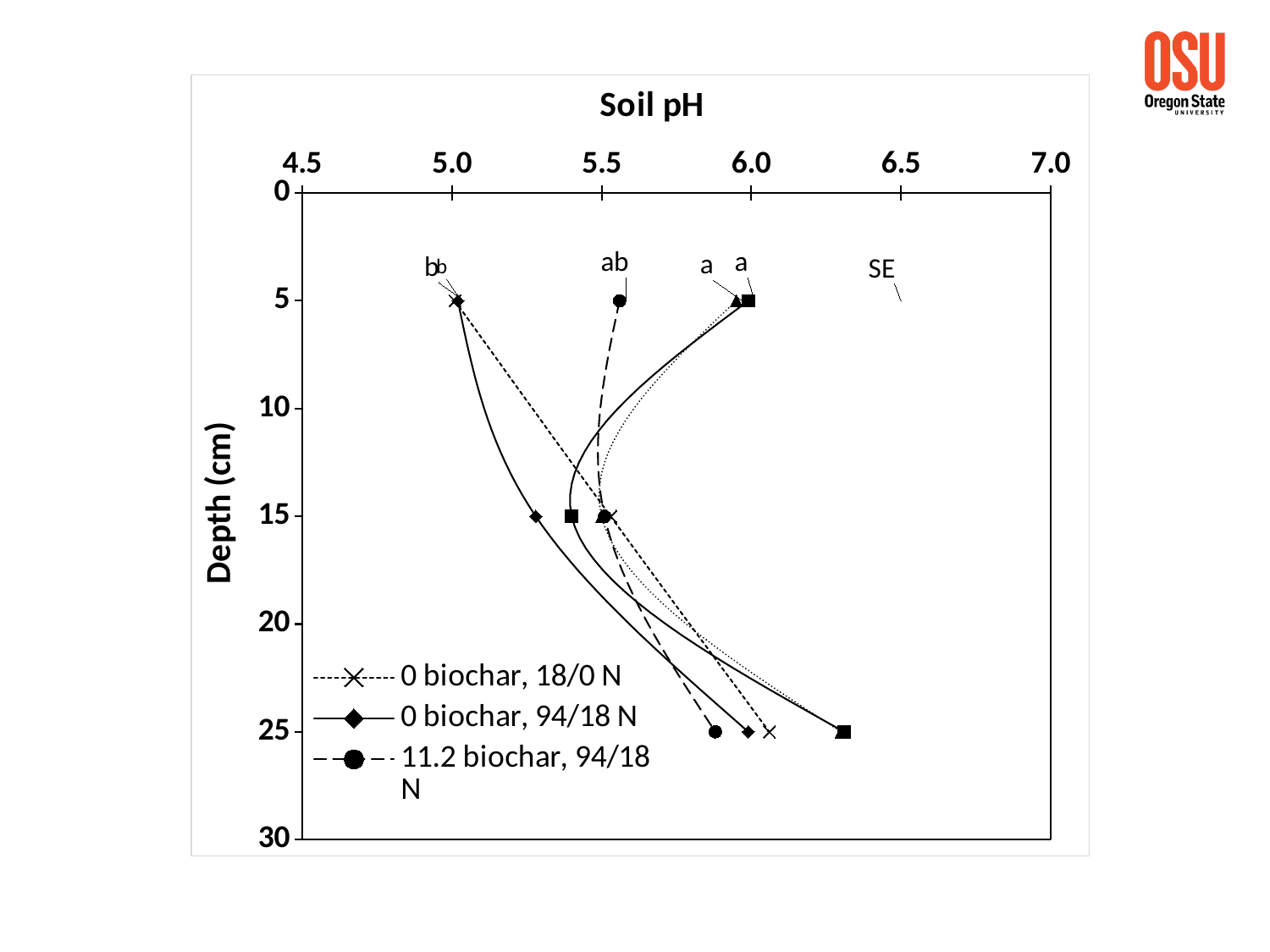
Is the soil pH for '0 biochar, 94/18 N' at 25 cm depth greater or less than 5.5? greater How many series does the chart's legend list? 3 At 5 cm depth, which has the higher soil pH: '0 biochar, 18/0 N' or '11.2 biochar, 94/18 N'? 11.2 biochar, 94/18 N What is the label of the vertical axis? Depth (cm) For the '0 biochar, 18/0 N' series, does soil pH rise or fall as depth increases from 5 cm to 25 cm? rise What is the title of the chart? Soil pH At 15 cm depth, which has the higher soil pH: '0 biochar, 94/18 N' or '11.2 biochar, 94/18 N'? 11.2 biochar, 94/18 N Is the soil pH for '11.2 biochar, 94/18 N' at 25 cm depth greater or less than 5.5? greater Is the soil pH for '11.2 biochar, 94/18 N' at 25 cm depth greater or less than 6.0? less What kind of chart is shown on the slide? line chart How many depth points are plotted for the '0 biochar, 18/0 N' series? 3